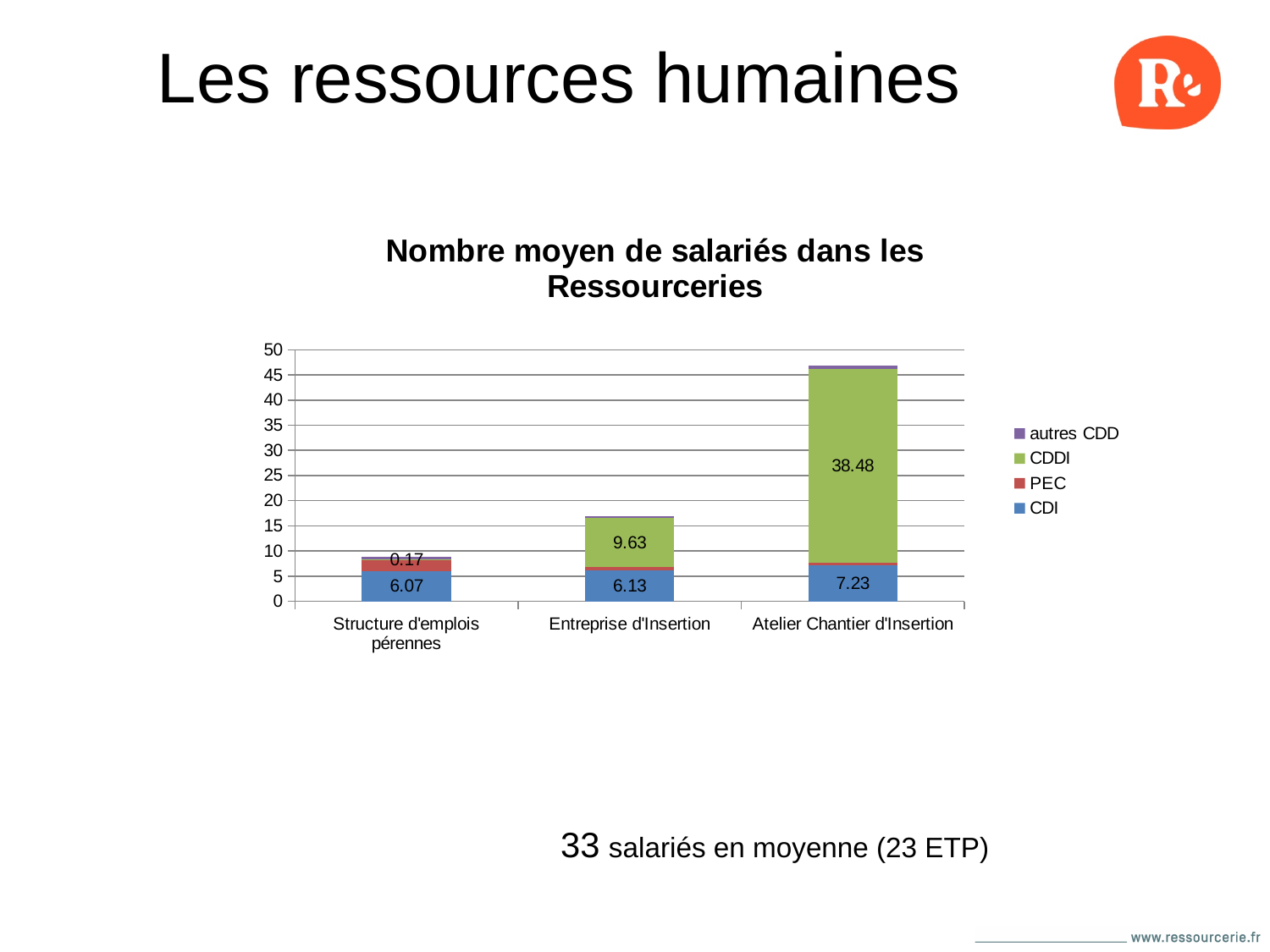
What kind of chart is shown on the slide? Stacked bar chart Is the total height of the stacked bar for Atelier Chantier d'Insertion greater or less than 40? greater What is the CDDI value for Atelier Chantier d'Insertion? 38.48 What is the CDI value for Entreprise d'Insertion? 6.13 What is the CDDI value for Entreprise d'Insertion? 9.63 What is the difference between the CDDI value for Atelier Chantier d'Insertion and the CDDI value for Entreprise d'Insertion? 28.85 Which category has the highest CDI value? Atelier Chantier d'Insertion What is the CDI value for Atelier Chantier d'Insertion? 7.23 How many series does the chart's legend list? 4 What is the title of the chart? Nombre moyen de salariés dans les Ressourceries How many categories are shown on the x axis of the chart? 3 What is the CDI value for Structure d'emplois pérennes? 6.07